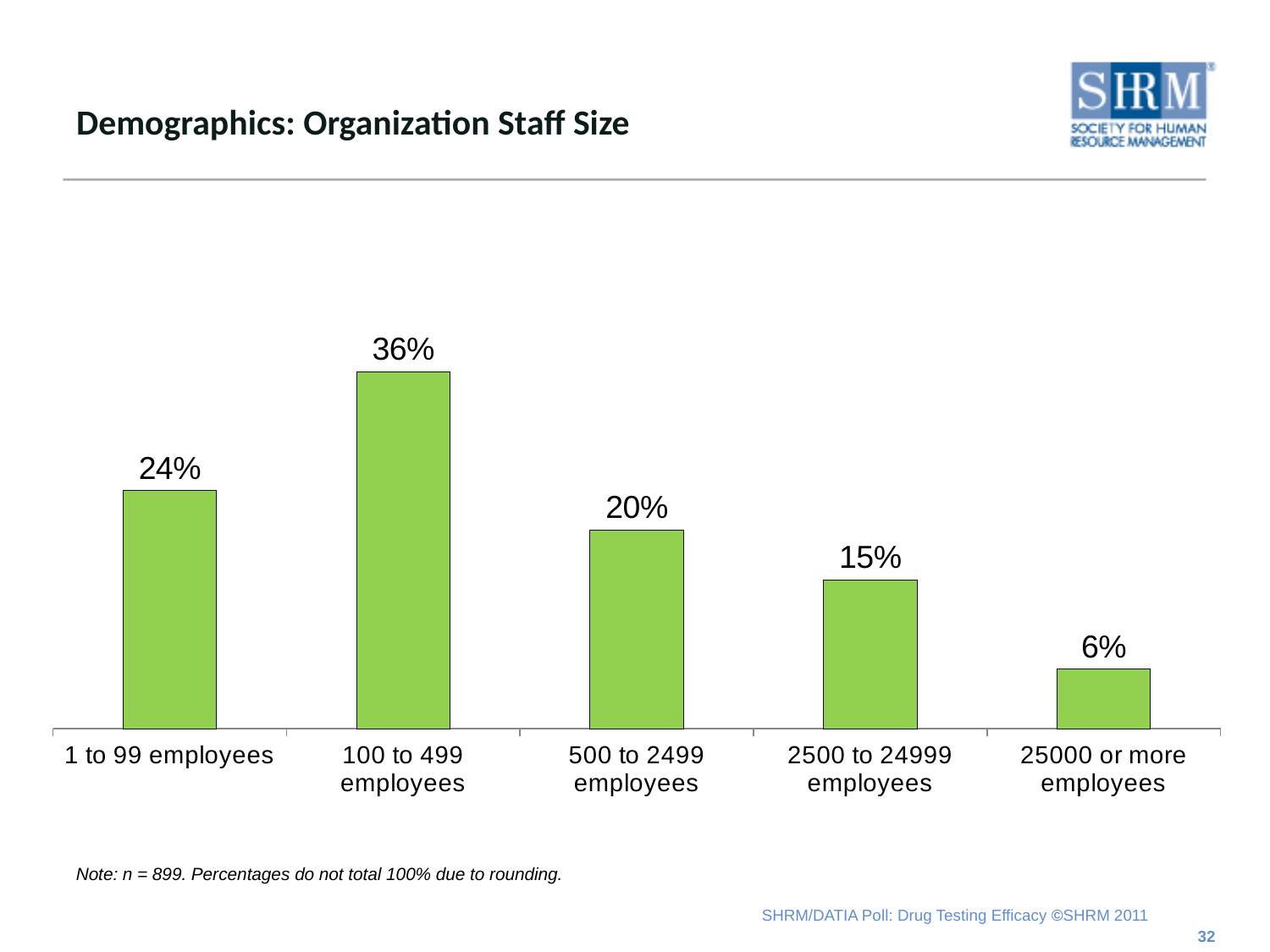
Which staff size category has the lowest percentage? 25000 or more employees What percentage of organizations have 25000 or more employees? 6% What percentage of organizations have 1 to 99 employees? 24% Which staff size category has the highest percentage? 100 to 499 employees What is the sample size (n) given in the note below the chart? 899 Which is larger: the percentage for 1 to 99 employees or for 500 to 2499 employees? 1 to 99 employees What is the difference in percentage points between the 100 to 499 employees category and the 500 to 2499 employees category? 16 How many staff size categories are shown in the chart? 5 What percentage of organizations have 2500 to 24999 employees? 15% What kind of chart is shown on the slide? Bar chart What is the title of the slide? Demographics: Organization Staff Size What percentage of organizations have 100 to 499 employees? 36%